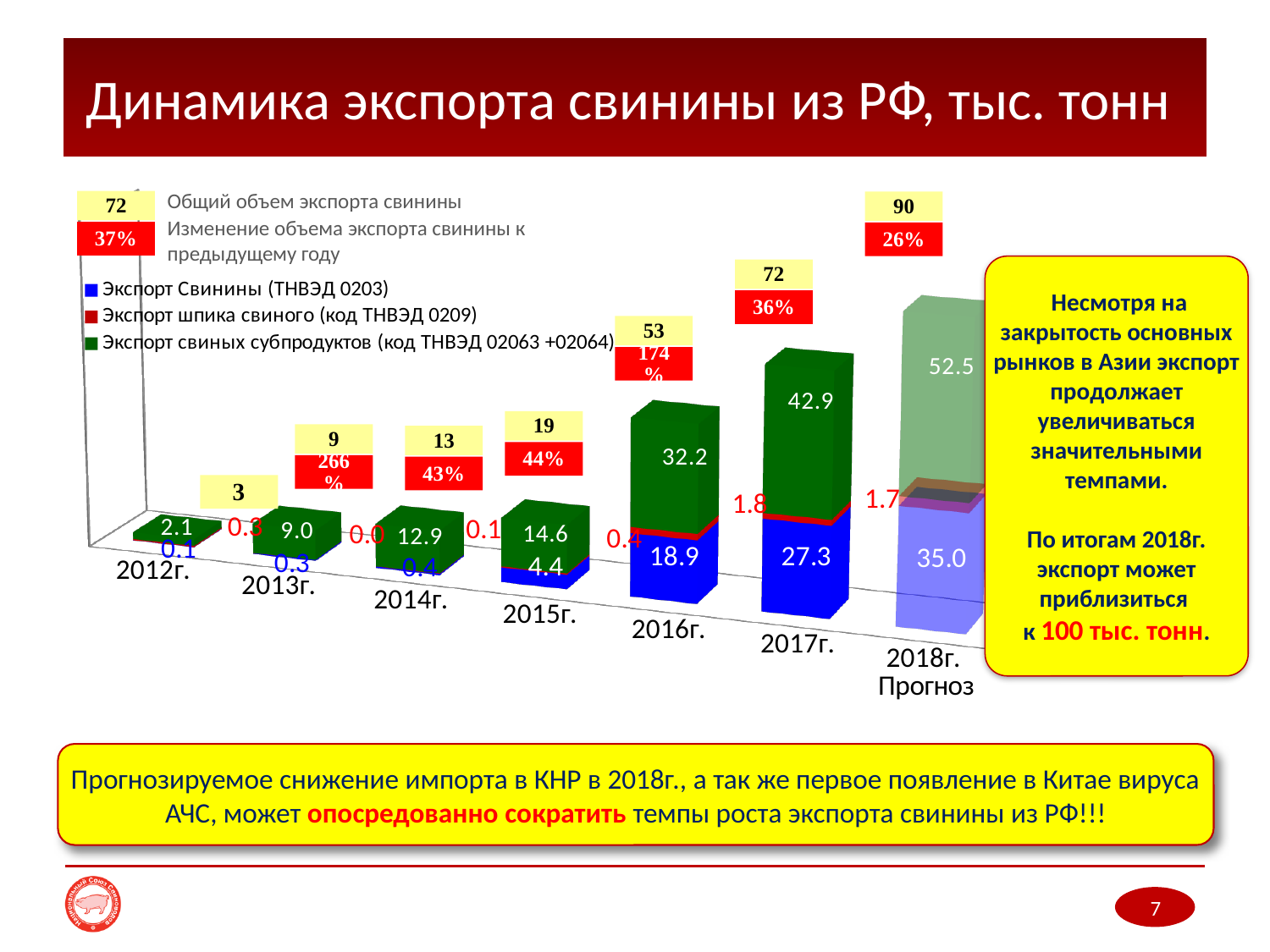
By how much did Экспорт Свинины (ТНВЭД 0203) increase from 2016г. to 2017г.? 8.4 How many series does the chart legend list? 3 What is the total pork export volume shown above the bar for 2016г.? 53 Which year has the lowest total pork export volume? 2012г. Which is larger in 2016г.: Экспорт Свинины (ТНВЭД 0203) or Экспорт свиных субпродуктов (код ТНВЭД 02063 +02064)? Экспорт свиных субпродуктов (код ТНВЭД 02063 +02064) What percentage change relative to the previous year is shown for 2013г.? 266% What is the value of Экспорт Свинины (ТНВЭД 0203) for 2018г. Прогноз? 35.0 How many years are shown on the x axis of the chart? 7 What kind of chart is shown on the slide? Stacked bar chart Does the total pork export volume rise or fall from 2012г. to 2018г. Прогноз? Rise Which year has the highest total pork export volume? 2018г. Прогноз What is the value of Экспорт свиных субпродуктов (код ТНВЭД 02063 +02064) for 2017г.? 42.9